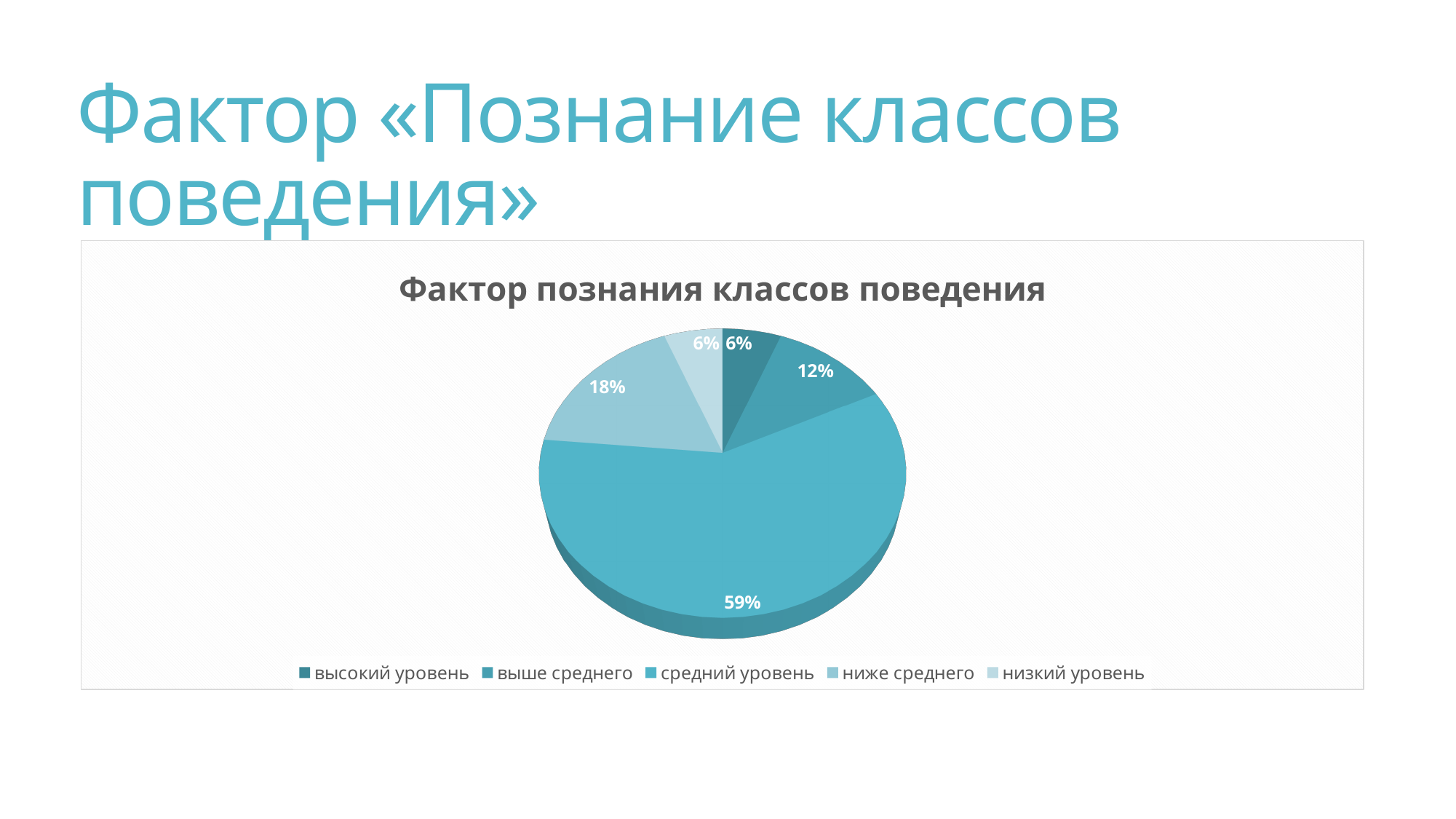
Which is larger, the slice for "ниже среднего" or the slice for "выше среднего"? ниже среднего Which category has the largest slice of the pie? средний уровень What is the difference in percentage points between "средний уровень" and "ниже среднего"? 41 What kind of chart is shown on the slide? pie chart What share of the pie is "выше среднего"? 12% What is the combined share of "высокий уровень" and "низкий уровень"? 12% What share of the pie is "ниже среднего"? 18% What share of the pie is "средний уровень"? 59% What is the chart's title? Фактор познания классов поведения How many slices does the pie chart have? 5 How many entries does the legend list? 5